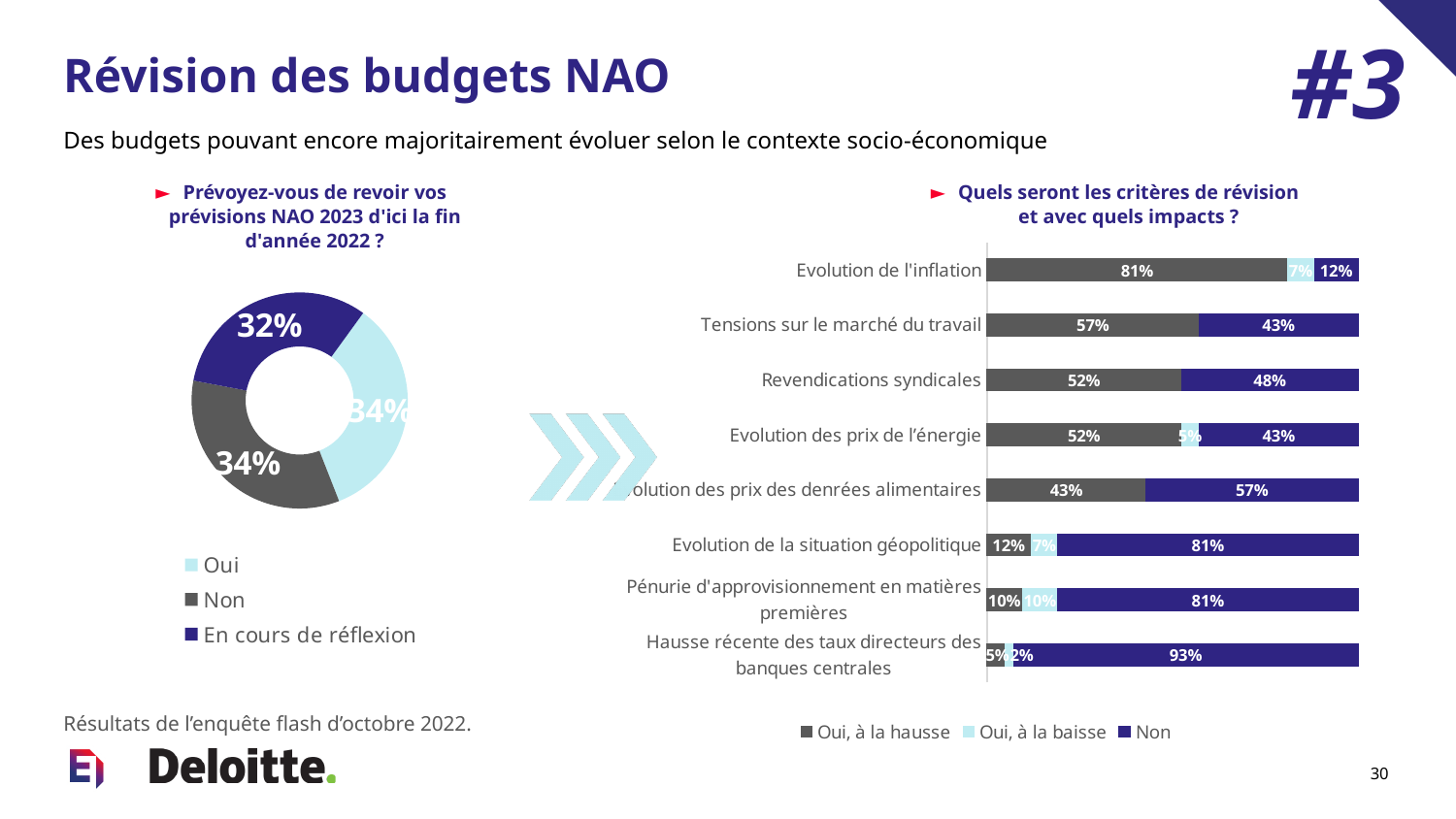
In the right chart, how many series does the legend list? 3 In the right chart, what is the "Non" value for "Tensions sur le marché du travail"? 43% In the right chart, what is the "Oui, à la hausse" value for "Evolution de l'inflation"? 81% In the right chart, which criterion has the highest "Oui, à la hausse" value? Evolution de l'inflation In the left chart, how many categories does the legend list? 3 In the left chart, what share of respondents answered "En cours de réflexion"? 32% In the left chart, what share of respondents answered "Oui"? 34% In the right chart, what is the "Non" value for "Hausse récente des taux directeurs des banques centrales"? 93% In the right chart, what is the difference between the "Oui, à la hausse" values for "Tensions sur le marché du travail" and "Evolution des prix des denrées alimentaires"? 14% In the right chart, which criterion has the highest "Non" value? Hausse récente des taux directeurs des banques centrales In the right chart, how many criteria (categories) are plotted? 8 What kind of chart is the left chart? Pie (donut) chart